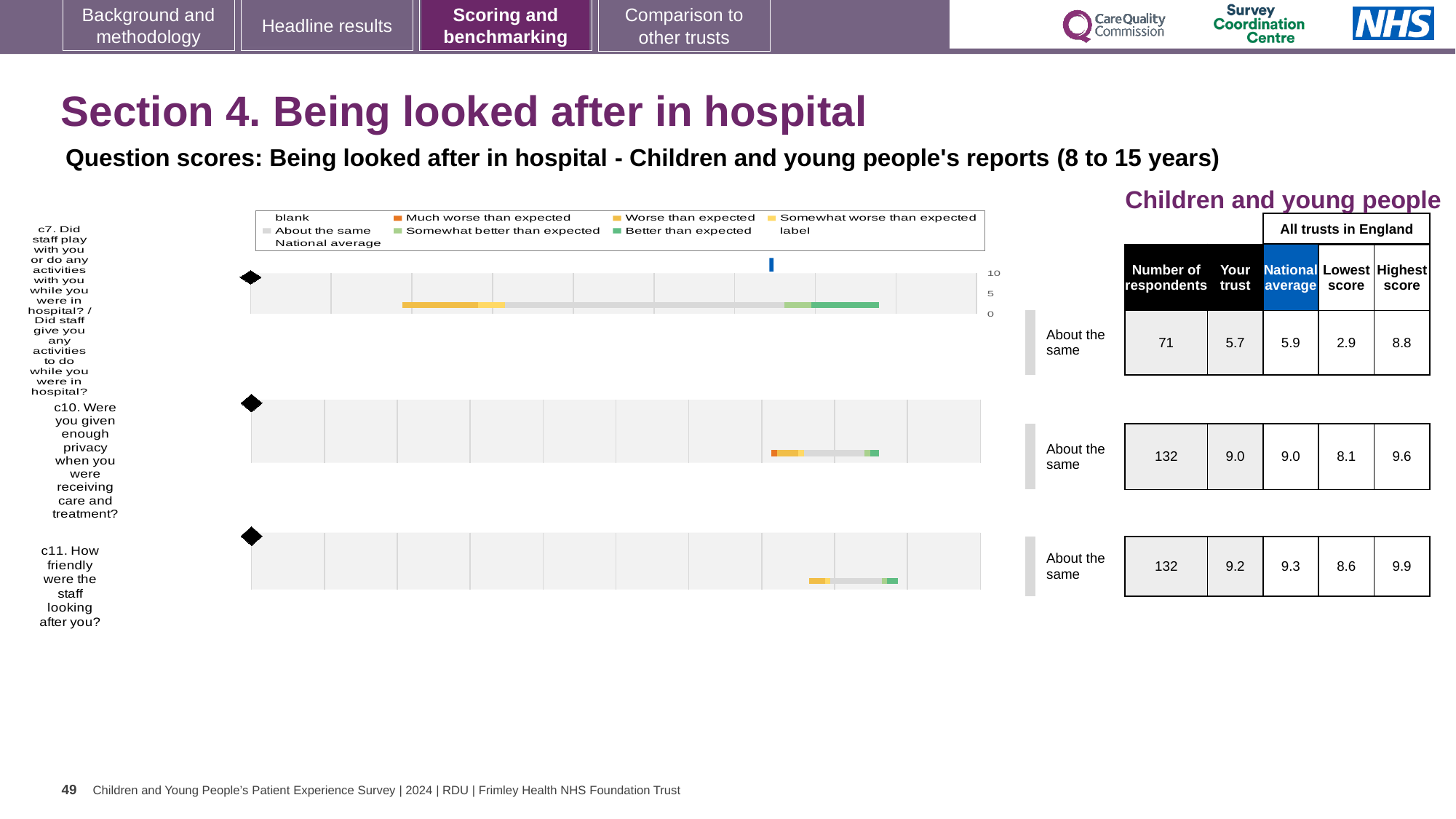
How many questions (chart rows) are plotted on the slide? 3 For c11, which is larger: the 'Your trust' score or the national average? National average What is the difference between the national average and the 'Your trust' score for c7? 0.2 What kind of chart is used to show the question scores on this slide? bar chart What benchmark category is shown for c10? About the same What is the national average score for c11 (How friendly were the staff looking after you?)? 9.3 Which question has the lowest 'Your trust' score? c7. Did staff play with you or do any activities with you while you were in hospital? How many respondents answered c7 (Did staff play with you or do any activities with you while you were in hospital?)? 71 What colour represents 'Better than expected' in the chart legend? Green What is the 'Your trust' score for c10 (Were you given enough privacy when you were receiving care and treatment?)? 9.0 Which question has the highest 'Your trust' score? c11. How friendly were the staff looking after you? What is the difference between the highest score and the lowest score across all trusts in England for c7? 5.9